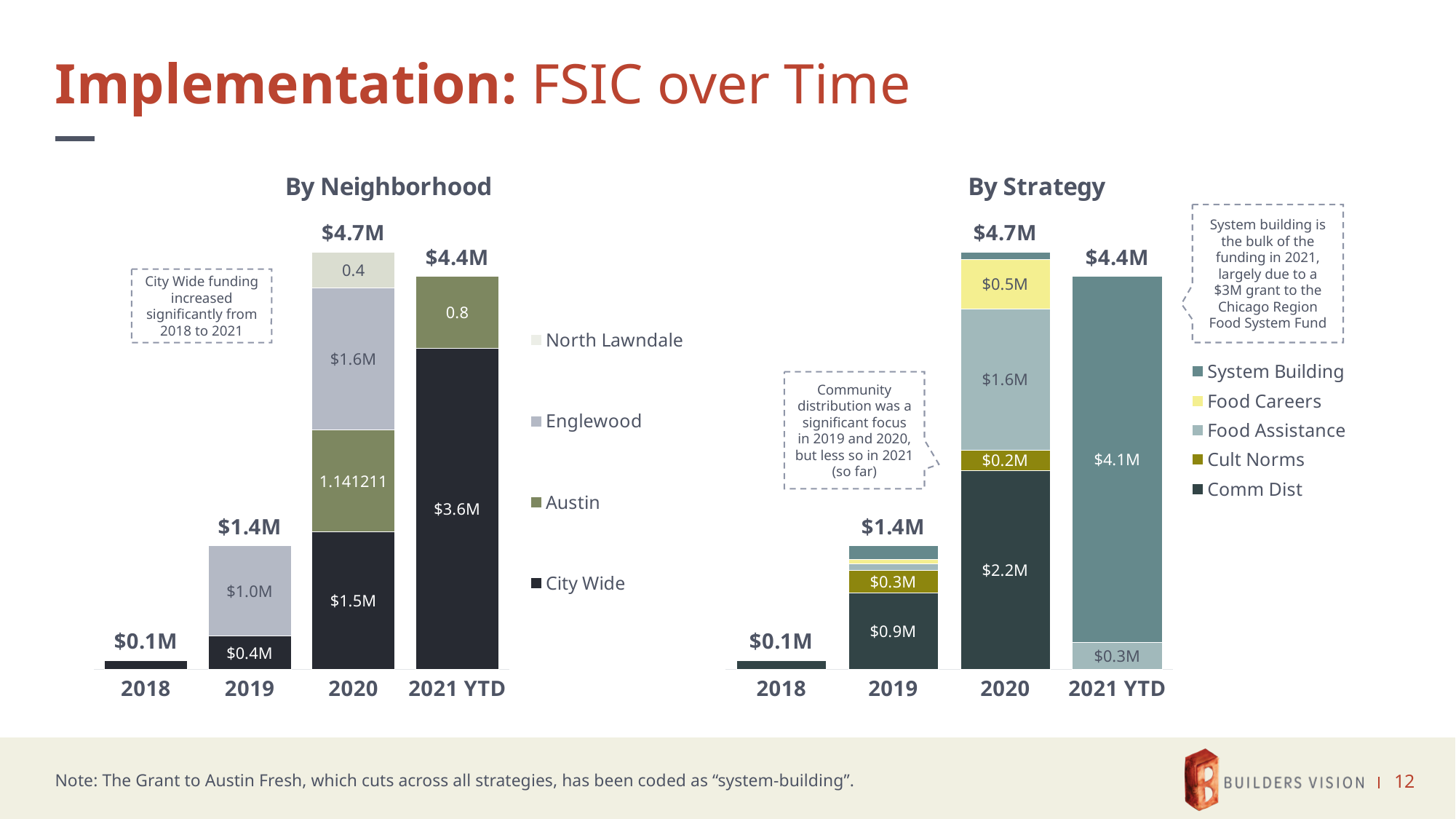
What kind of chart is the By Strategy chart? Stacked bar chart In the By Neighborhood chart, what is the Englewood value for 2019? $1.0M In the By Neighborhood chart, what is the City Wide value for 2021 YTD? $3.6M In the By Strategy chart, what is the Comm Dist value for 2020? $2.2M In the By Strategy chart, what is the difference between the Comm Dist values for 2020 and 2019? $1.3M In the By Neighborhood chart, which year has the lowest total? 2018 In the By Neighborhood chart, which year has the highest total? 2020 In the By Strategy chart, how many series does the legend list? 5 In the By Strategy chart, what is the System Building value for 2021 YTD? $4.1M In the By Neighborhood chart, how many series does the legend list? 4 In the By Strategy chart, which is larger for 2020: Food Assistance or Food Careers? Food Assistance In the By Neighborhood chart, what is the total for 2020? $4.7M